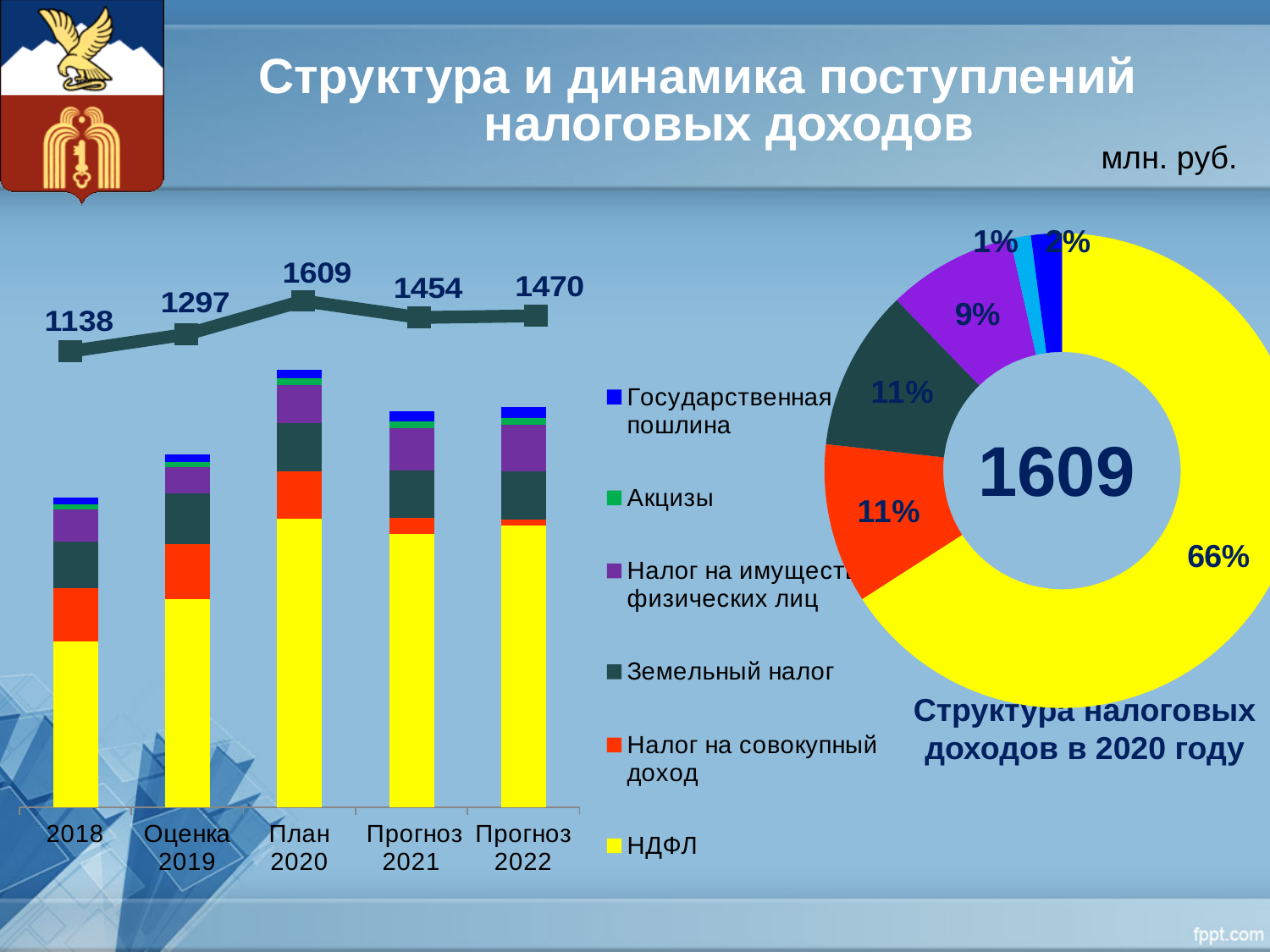
On the left chart, what is the difference between the totals for План 2020 and Прогноз 2021? 155 On the left chart, what is the total value shown for Прогноз 2022? 1470 On the donut chart 'Структура налоговых доходов в 2020 году', what share does Налог на имущество физических лиц have? 9% On the left chart, which period has the highest total value? План 2020 On the left chart, how many series does the legend list? 6 On the left chart, what is the total tax revenue value shown for 2018? 1138 What type of chart is the one on the left of the slide? Stacked bar chart with a line On the left chart, which total is larger: Оценка 2019 or Прогноз 2022? Прогноз 2022 On the left chart, what is the total value shown for План 2020? 1609 On the left chart, which period has the lowest total value? 2018 On the donut chart 'Структура налоговых доходов в 2020 году', what share does НДФЛ have? 66% On the left chart, how many periods are shown on the x axis? 5